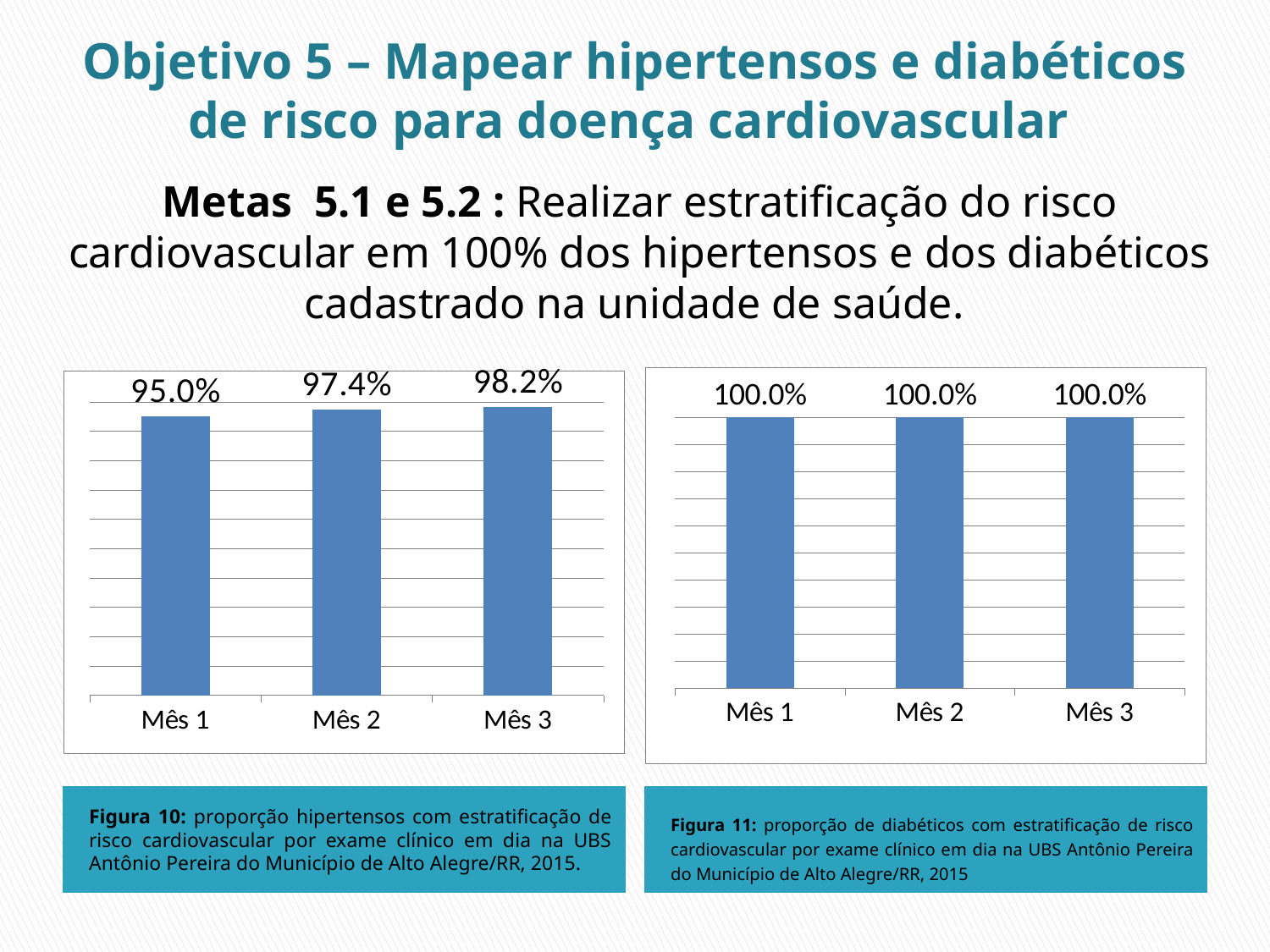
In the left chart (Figura 10, hipertensos), do the values rise or fall from Mês 1 to Mês 3? rise In the left chart (Figura 10, hipertensos), which month has the highest value? Mês 3 What kind of chart is the right chart (Figura 11, diabéticos)? bar chart In the left chart (Figura 10, hipertensos), which is larger, the value for Mês 2 or Mês 1? Mês 2 In the left chart (Figura 10, hipertensos), what is the value for Mês 3? 98.2% In the right chart (Figura 11, diabéticos), what is the difference between the values for Mês 3 and Mês 1? 0.0% In the left chart (Figura 10, hipertensos), what is the difference between the values for Mês 3 and Mês 1? 3.2% In the right chart (Figura 11, diabéticos), how many months are plotted? 3 In the right chart (Figura 11, diabéticos), what is the value for Mês 2? 100.0% In the left chart (Figura 10, hipertensos), which month has the lowest value? Mês 1 In the left chart (Figura 10, hipertensos), what is the value for Mês 1? 95.0% In the left chart (Figura 10, hipertensos), how many bars are shown? 3